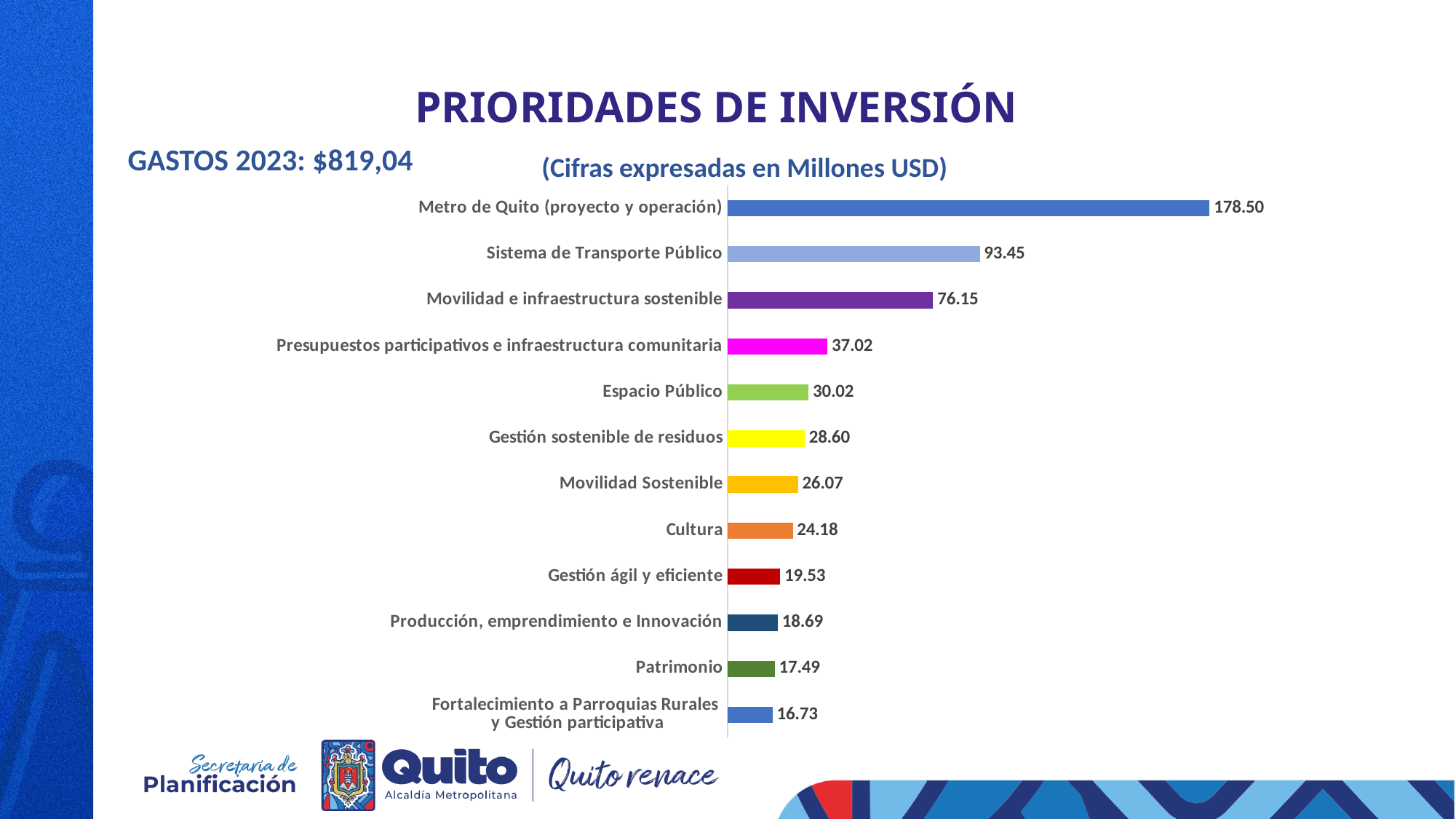
What is the difference between Sistema de Transporte Público and Movilidad e infraestructura sostenible? 17.30 Which is larger, Cultura or Gestión ágil y eficiente? Cultura How many categories are shown in the chart? 12 What is the value for Metro de Quito (proyecto y operación)? 178.50 Which category has the lowest value? Fortalecimiento a Parroquias Rurales y Gestión participativa What is the value for Patrimonio? 17.49 Which category has the highest value? Metro de Quito (proyecto y operación) In what units are the figures in the chart expressed, according to the subtitle? Millones USD What is the value for Espacio Público? 30.02 What kind of chart is shown on the slide? Bar chart What is the difference between Metro de Quito (proyecto y operación) and Sistema de Transporte Público? 85.05 Which is larger, Gestión sostenible de residuos or Movilidad Sostenible? Gestión sostenible de residuos